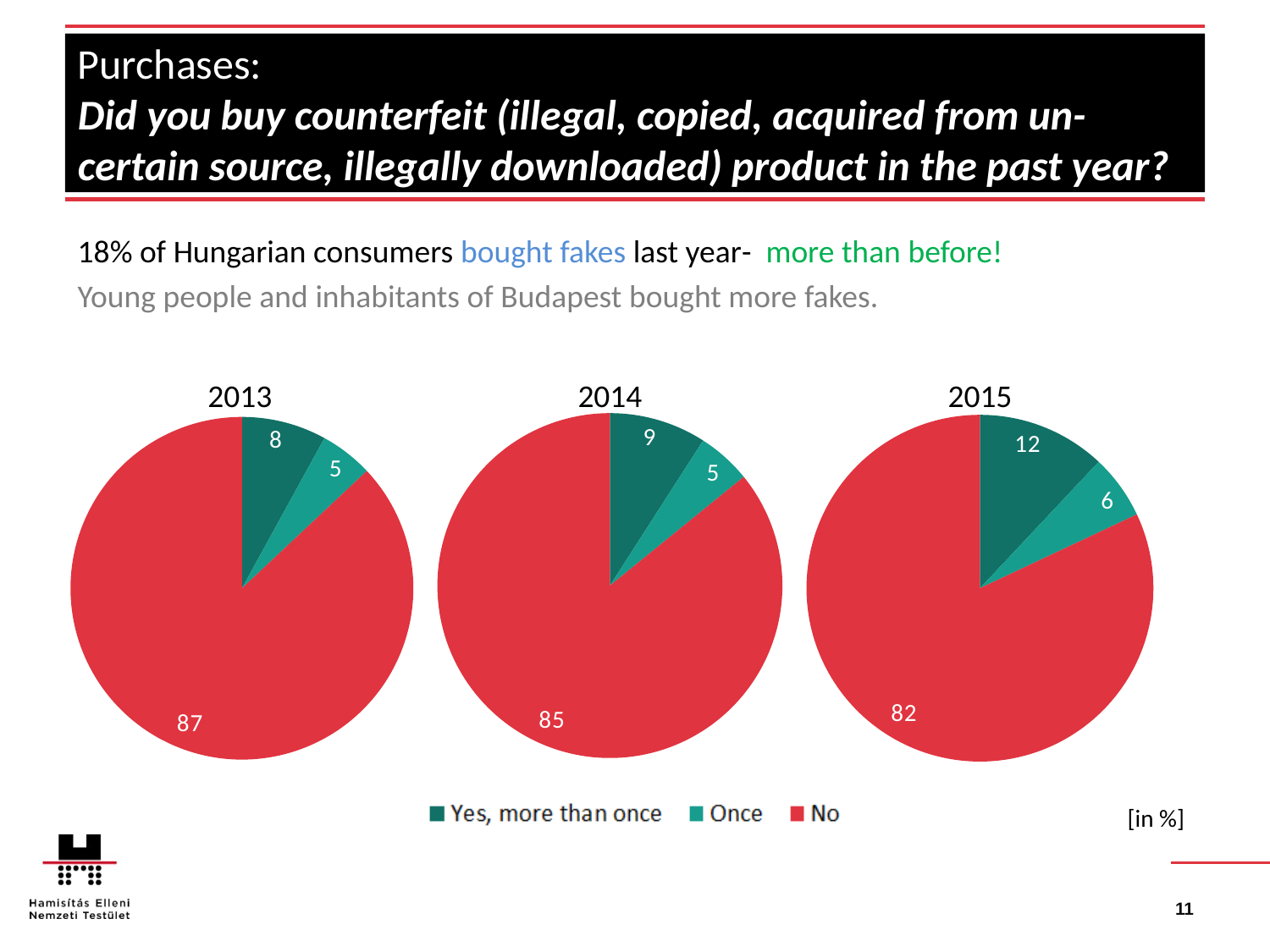
What is the difference between the "No" value in the 2013 pie chart and the "No" value in the 2015 pie chart? 5 In the 2015 pie chart, what is the value for "Once"? 6 Which is larger: the "Yes, more than once" value in the 2014 pie chart or in the 2015 pie chart? 2015 How many categories does the legend list for the pie charts? 3 In the 2015 pie chart, which category has the smallest slice? Once In the 2015 pie chart, what is the value for "No"? 82 Which colour represents "No" in the pie charts? Red In the 2013 pie chart, what is the value for "No"? 87 In the 2013 pie chart, which category has the largest slice? No How many pie charts are shown on the slide? 3 What kind of chart is used to show the 2014 data? Pie chart In the 2014 pie chart, what is the value for "Yes, more than once"? 9